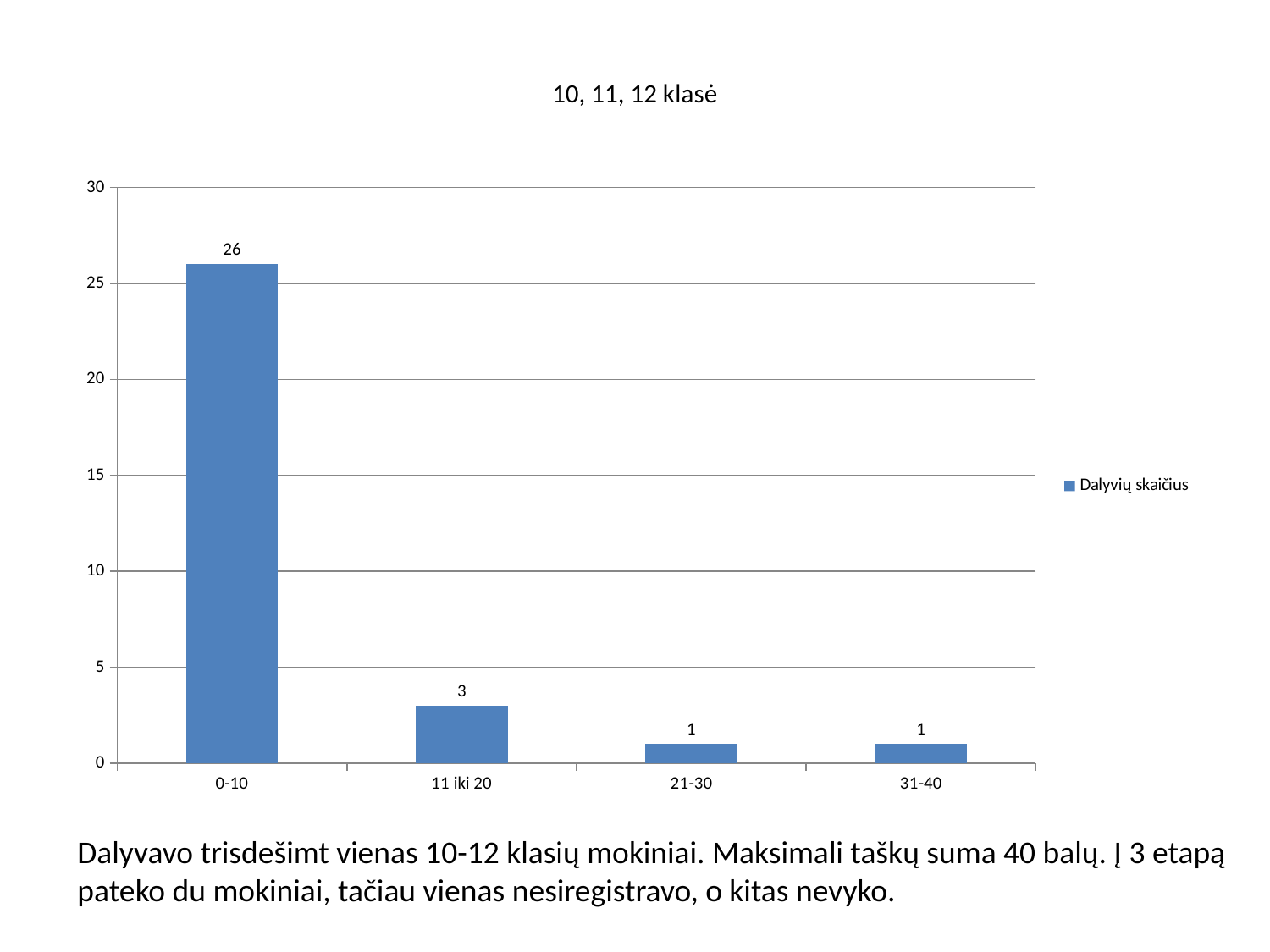
Do the values rise or fall from left to right along the x axis? fall What is the value for the 21-30 category? 1 Which category has the highest value? 0-10 What is the difference between the values for 0-10 and 11 iki 20? 23 Which is larger, the value for 11 iki 20 or the value for 31-40? 11 iki 20 Is the value for 0-10 greater or less than 25? greater How many categories are shown on the x axis? 4 What kind of chart is shown on the slide? bar chart What is the title of the chart? 10, 11, 12 klasė What is the value for the 0-10 category? 26 What is the value for the 11 iki 20 category? 3 How many series does the legend list? 1